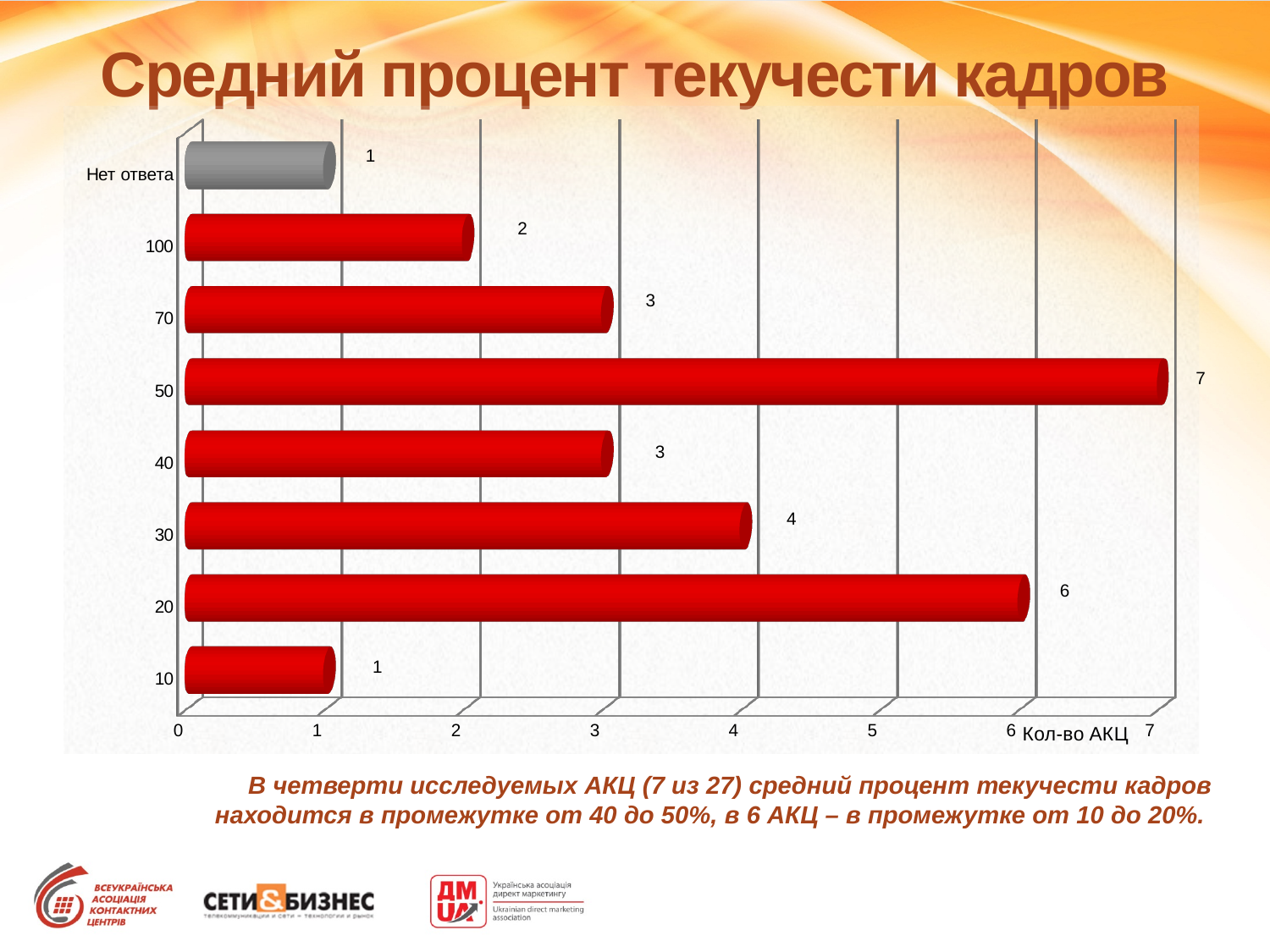
What is the value for the category "50"? 7 What is the value for the category "20"? 6 What is the difference between the values for "30" and "100"? 2 How many categories are shown in the chart? 8 Which category has the highest value? 50 Is the value for "20" greater or less than 5? greater What is the difference between the values for "50" and "20"? 1 What is the value for the category "Нет ответа"? 1 What kind of chart is shown on the slide? bar chart Which is larger, the value for "70" or the value for "100"? 70 What is the title of the chart? Средний процент текучести кадров What is the value for the category "30"? 4